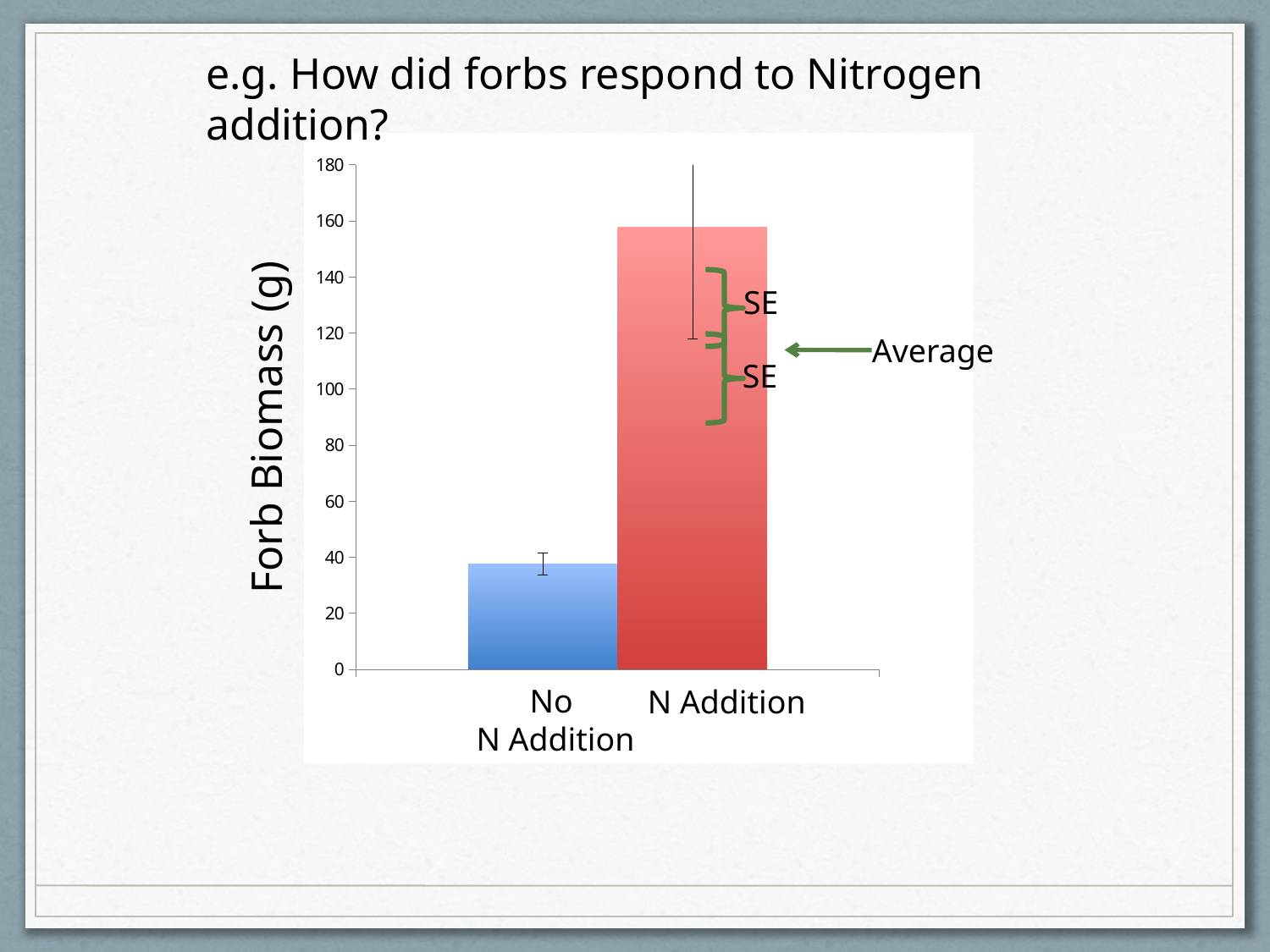
Is the value for No N Addition greater or less than 60? less What is the label of the y axis? Forb Biomass (g) Which is larger, the forb biomass for N Addition or for No N Addition? N Addition Is the value for N Addition greater or less than 180? less How many categories are plotted on the x axis? 2 What kind of chart is shown on the slide? bar chart Is the value for N Addition greater or less than 140? greater Which category has the lowest forb biomass? No N Addition What does the green arrow on the chart point to? Average Which category has the highest forb biomass? N Addition